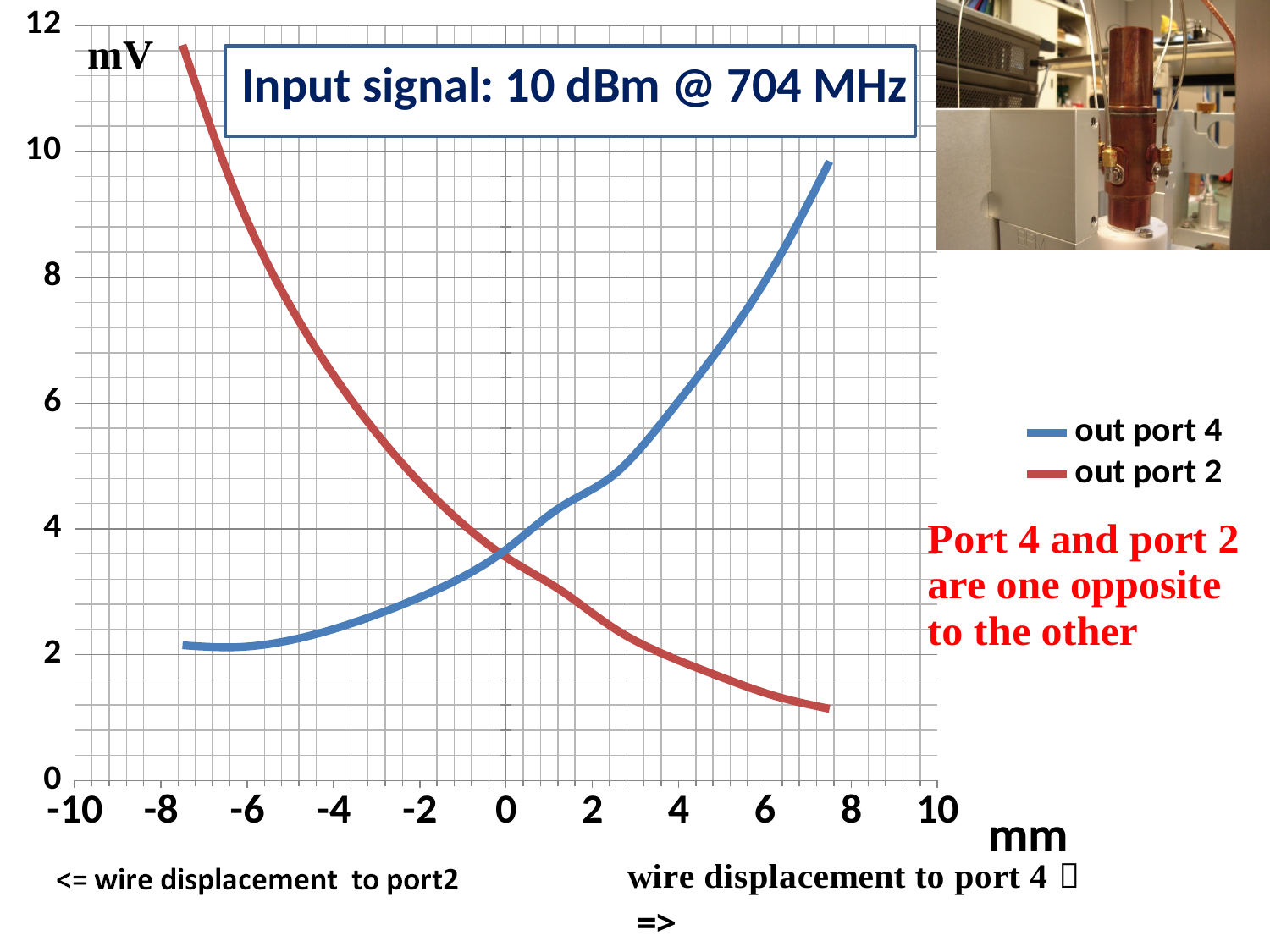
Is the value for out port 4 at -6 mm greater or less than 4 mV? less Does the out port 2 line rise or fall as the wire displacement increases from left to right? falls What are the two series named in the legend? out port 4 and out port 2 How many series does the legend list? 2 At a displacement of 4 mm, which series has the higher value, out port 4 or out port 2? out port 4 At a displacement of -4 mm, which series has the higher value, out port 4 or out port 2? out port 2 Is the value for out port 4 at 6 mm greater or less than 6 mV? greater What is the title text shown in the box on the chart? Input signal: 10 dBm @ 704 MHz Does the out port 4 line rise or fall as the wire displacement increases from left to right? rises Is the value for out port 2 at 4 mm greater or less than 4 mV? less What kind of chart is shown on the slide? line chart